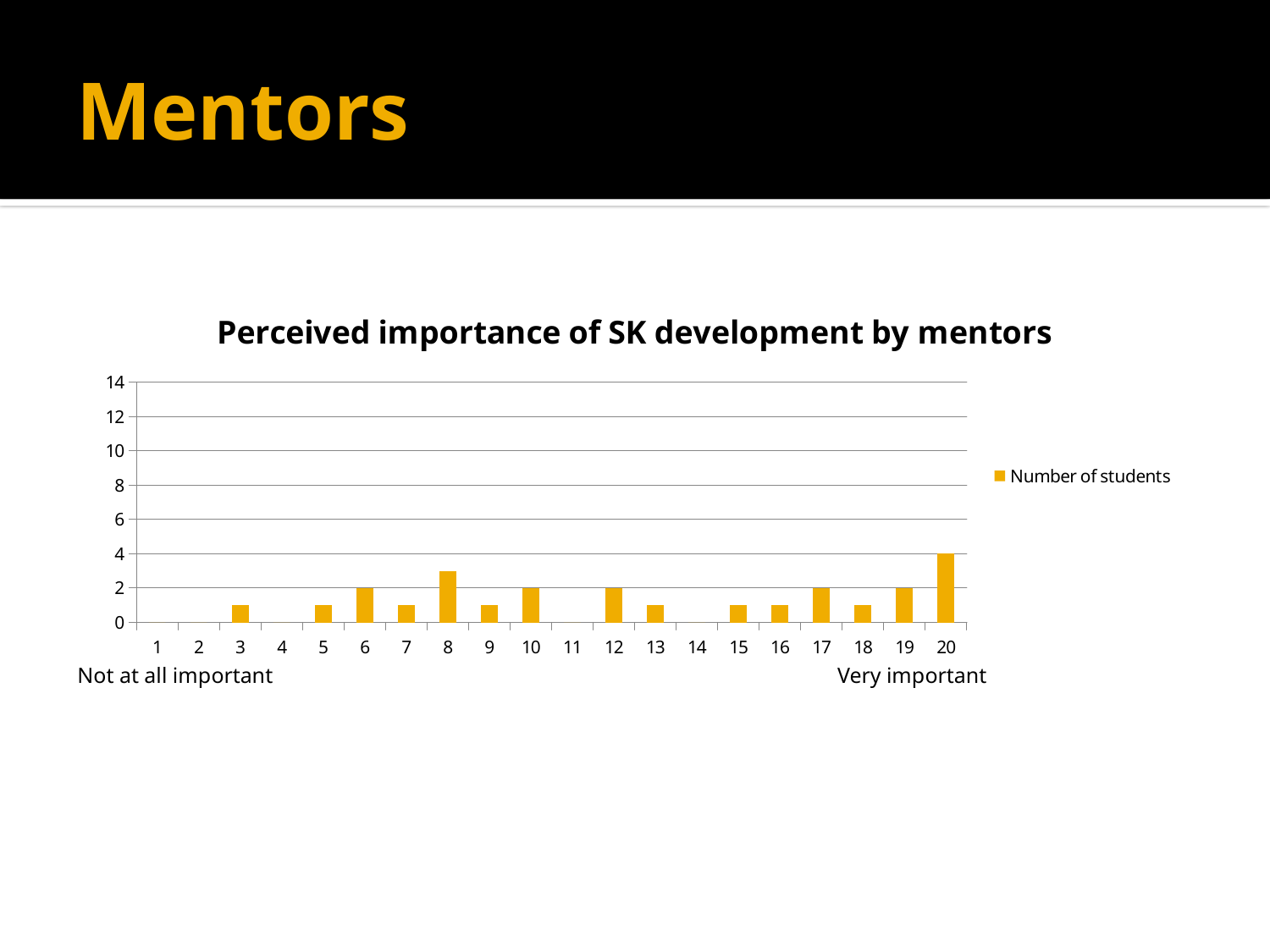
Which has more students, category 20 or category 8? 20 What is the number of students for category 6? 2 Is the value for category 8 greater or less than 2? greater What is the title of the chart? Perceived importance of SK development by mentors Which category has the highest number of students? 20 What is the number of students for category 19? 2 How many categories are shown on the x axis? 20 How many series does the legend list? 1 What kind of chart is shown on the slide? bar chart What is the name of the series shown in the legend? Number of students What is the difference between the number of students for category 20 and category 6? 2 What is the number of students for category 20? 4